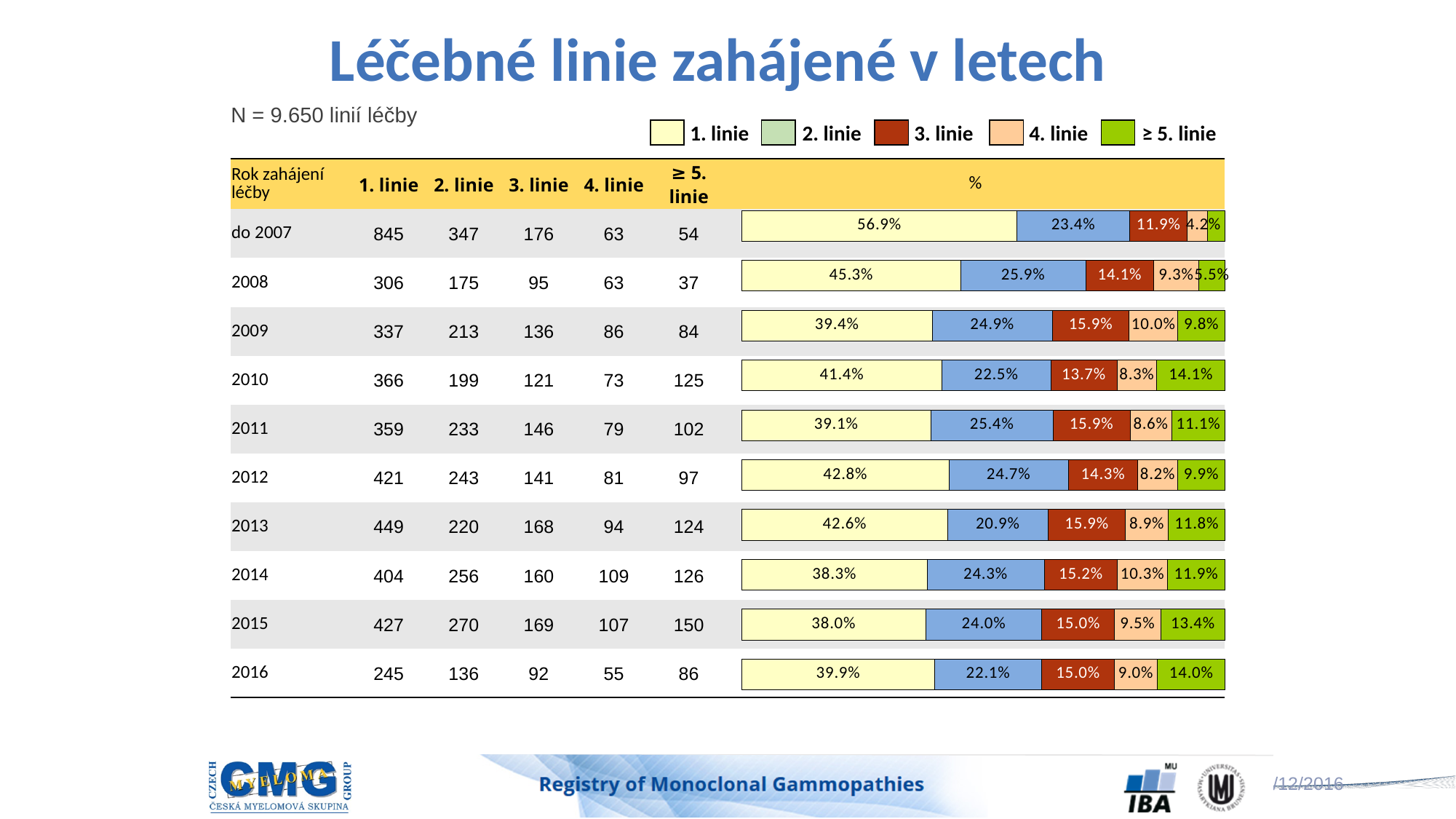
What is the percentage for ≥ 5. linie in 2016? 14.0% What is the difference between the 2. linie percentage in 2008 and in 2013? 5.0% What is the percentage for 1. linie in 2010? 41.4% How many years (bars) are shown in the chart? 10 What kind of chart is shown next to the table on the slide? stacked bar chart Does the 1. linie percentage generally rise or fall from 'do 2007' to 2016? fall Which year has the highest percentage for 1. linie? do 2007 What is the percentage for 3. linie in 2009? 15.9% Which year has the lowest percentage for 1. linie? 2015 How many series does the legend above the chart list? 5 Which is larger, the ≥ 5. linie percentage in 2010 or in 2015? 2010 What is the first entry in the chart legend? 1. linie